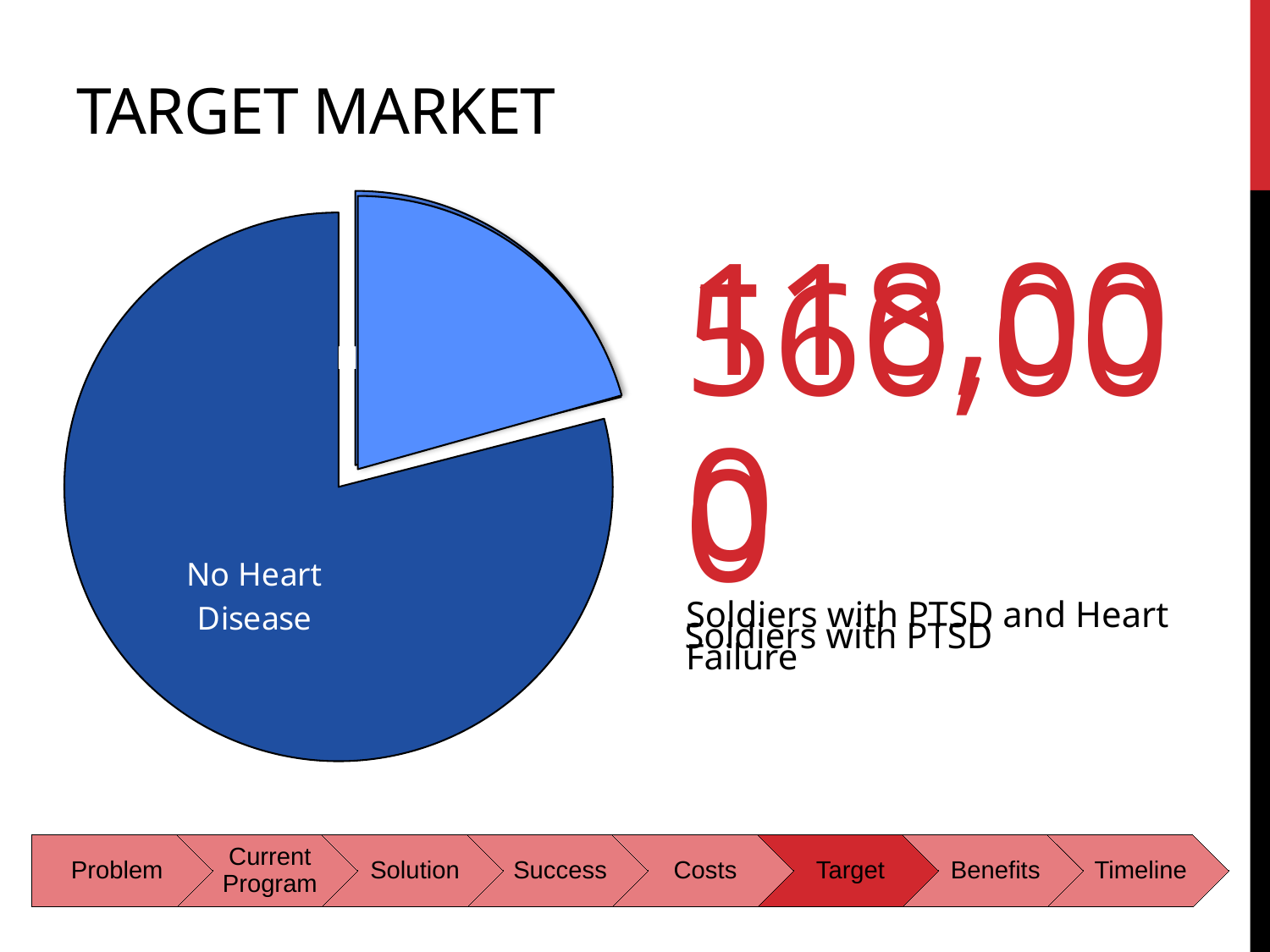
Which is larger in the pie chart: the No Heart Disease slice or the light blue slice pulled out from the pie? No Heart Disease What kind of chart is shown on the slide? pie chart How many slices does the pie chart have? 2 Which slice of the pie chart is the largest? No Heart Disease What colour is the No Heart Disease slice of the pie chart? dark blue Which slice of the pie chart is pulled out (exploded) from the rest of the pie? the light blue slice